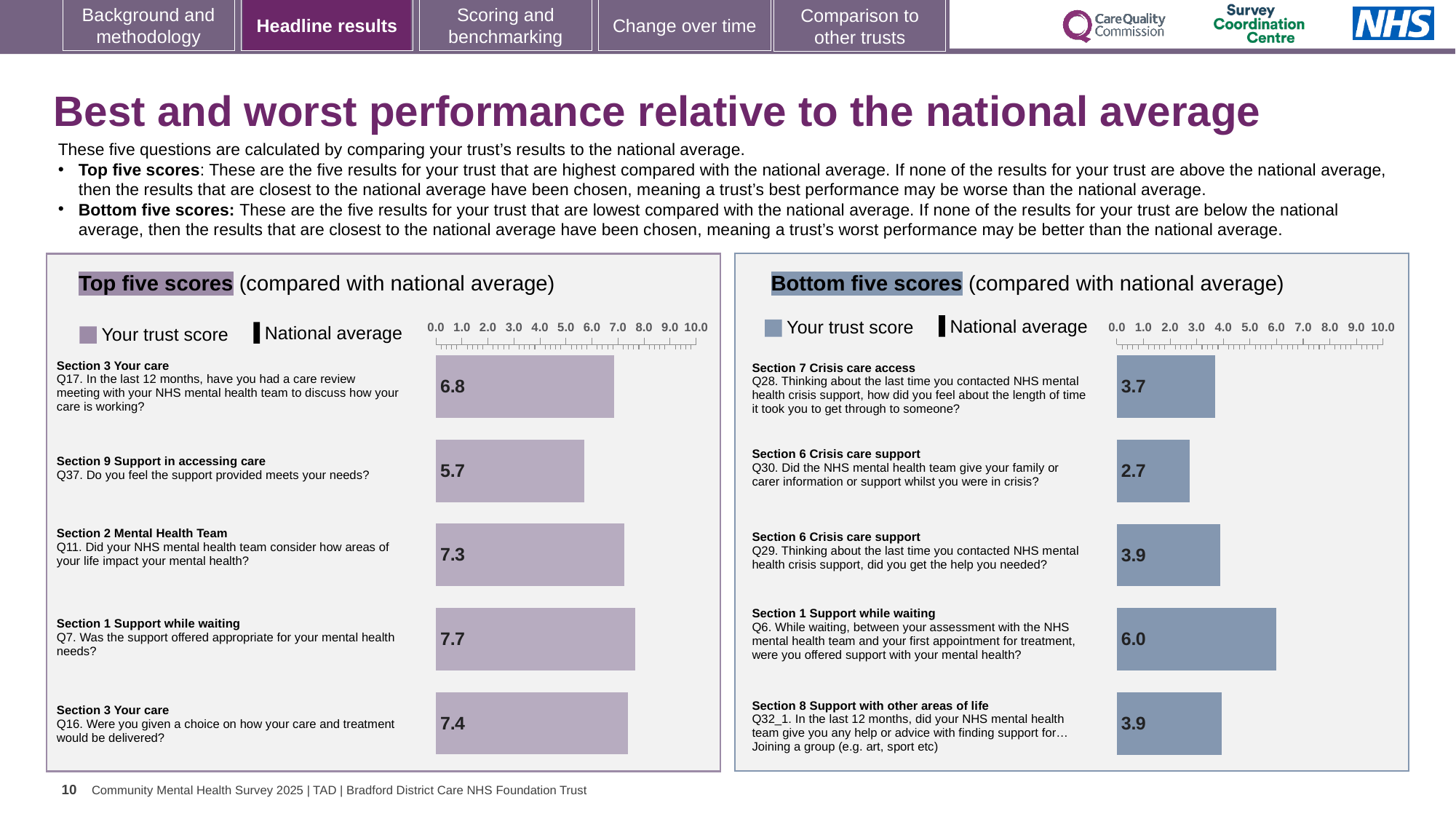
In the Bottom five scores chart, is the trust score for Q28 greater or less than 4.0? less In the Top five scores chart, which has the higher trust score, Q11 or Q16? Q16 (7.4) In the Top five scores chart, what is the trust score for Q17 (care review meeting with your NHS mental health team)? 6.8 In the Top five scores chart, which question has the lowest trust score? Q37 (Section 9 Support in accessing care), 5.7 In the Top five scores chart, which question has the highest trust score? Q7 (Section 1 Support while waiting), 7.7 In the Top five scores chart, what is the difference between the trust scores for Q7 and Q37? 2.0 In the Bottom five scores chart, what is the difference between the trust scores for Q6 and Q30? 3.3 In the Bottom five scores chart, which question has the highest trust score? Q6 (Section 1 Support while waiting), 6.0 In the Bottom five scores chart, which question has the lowest trust score? Q30 (Section 6 Crisis care support), 2.7 What type of chart is used in the Top five scores panel? Bar chart In the Bottom five scores chart, what is the trust score for Q6 (support offered while waiting between assessment and first appointment)? 6.0 How many bars are plotted in the Bottom five scores chart? 5